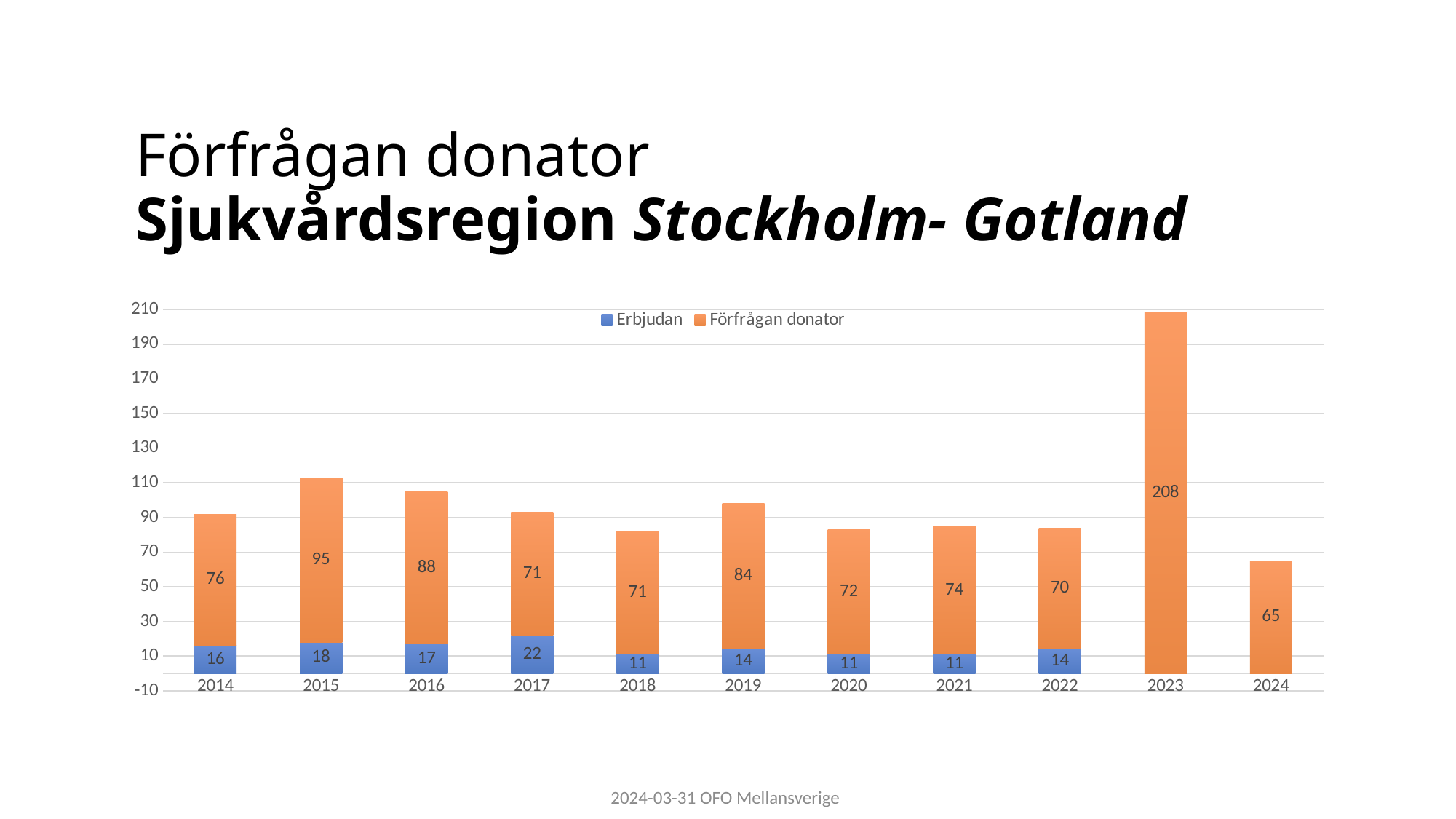
What is the value of Erbjudan for 2017? 22 Which year has the highest value for Förfrågan donator? 2023 What is the value of Förfrågan donator for 2023? 208 What is the difference between the Förfrågan donator values for 2015 and 2014? 19 How many years are shown on the x axis? 11 What is the total of the stacked bar for 2015? 113 What is the value of Förfrågan donator for 2024? 65 Which is larger, the Förfrågan donator value for 2016 or for 2019? 2016 Which year has the lowest value for Förfrågan donator? 2024 What kind of chart is shown on the slide? Stacked bar chart How many series does the legend list? 2 Which year has the highest value for Erbjudan? 2017